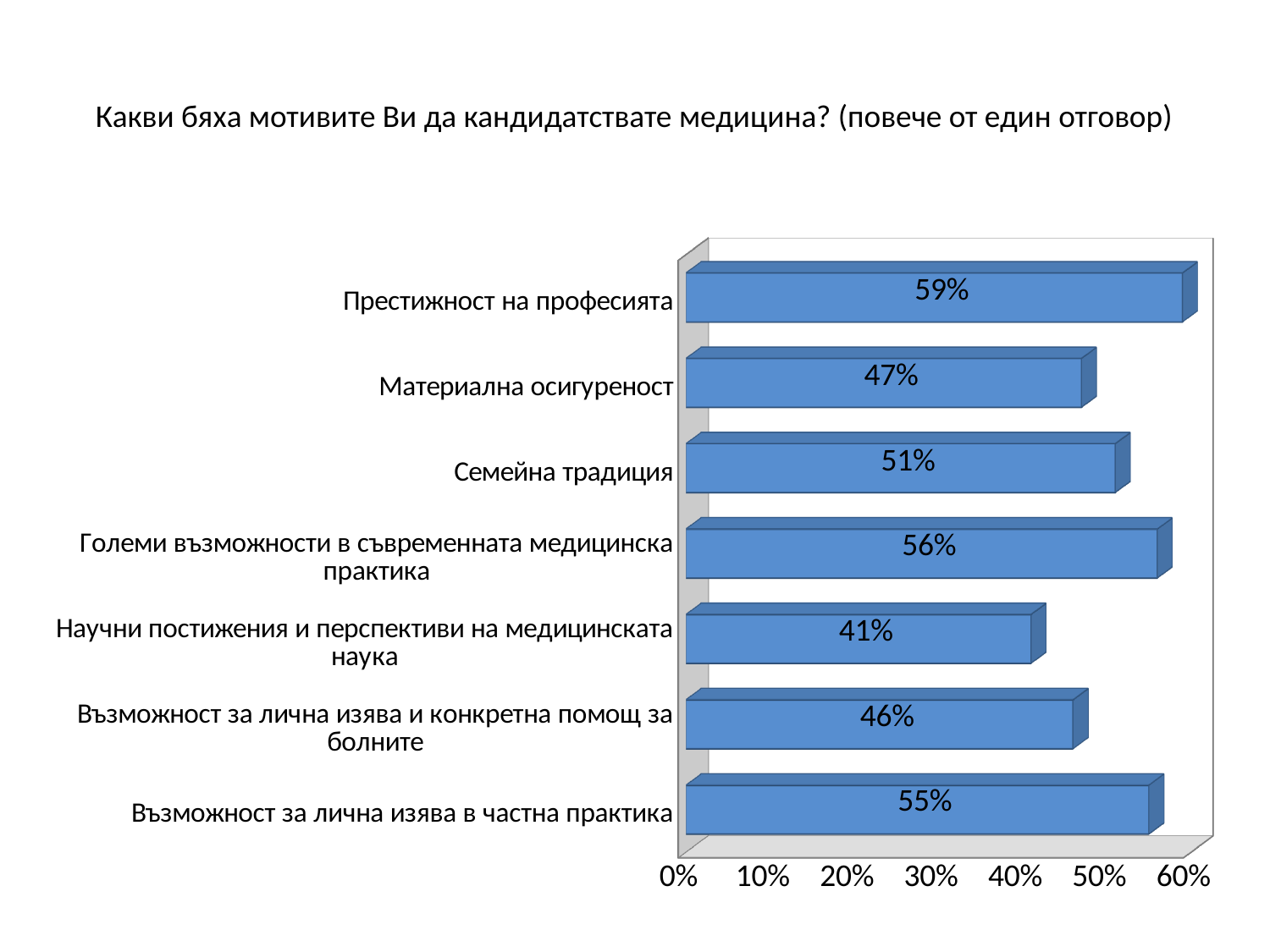
What is the title of the chart? Какви бяха мотивите Ви да кандидатствате медицина? (повече от един отговор) Is the value for Възможност за лична изява в частна практика greater or less than 50%? greater Which category has the highest value? Престижност на професията What is the value for Материална осигуреност? 47% How many categories are shown in the chart? 7 What kind of chart is shown on the slide? bar chart Which category has the lowest value? Научни постижения и перспективи на медицинската наука What is the difference between the values for Престижност на професията and Научни постижения и перспективи на медицинската наука? 18% Which is larger: the value for Семейна традиция or the value for Материална осигуреност? Семейна традиция What is the value for Престижност на професията? 59% What is the value for Научни постижения и перспективи на медицинската наука? 41% What is the value for Семейна традиция? 51%